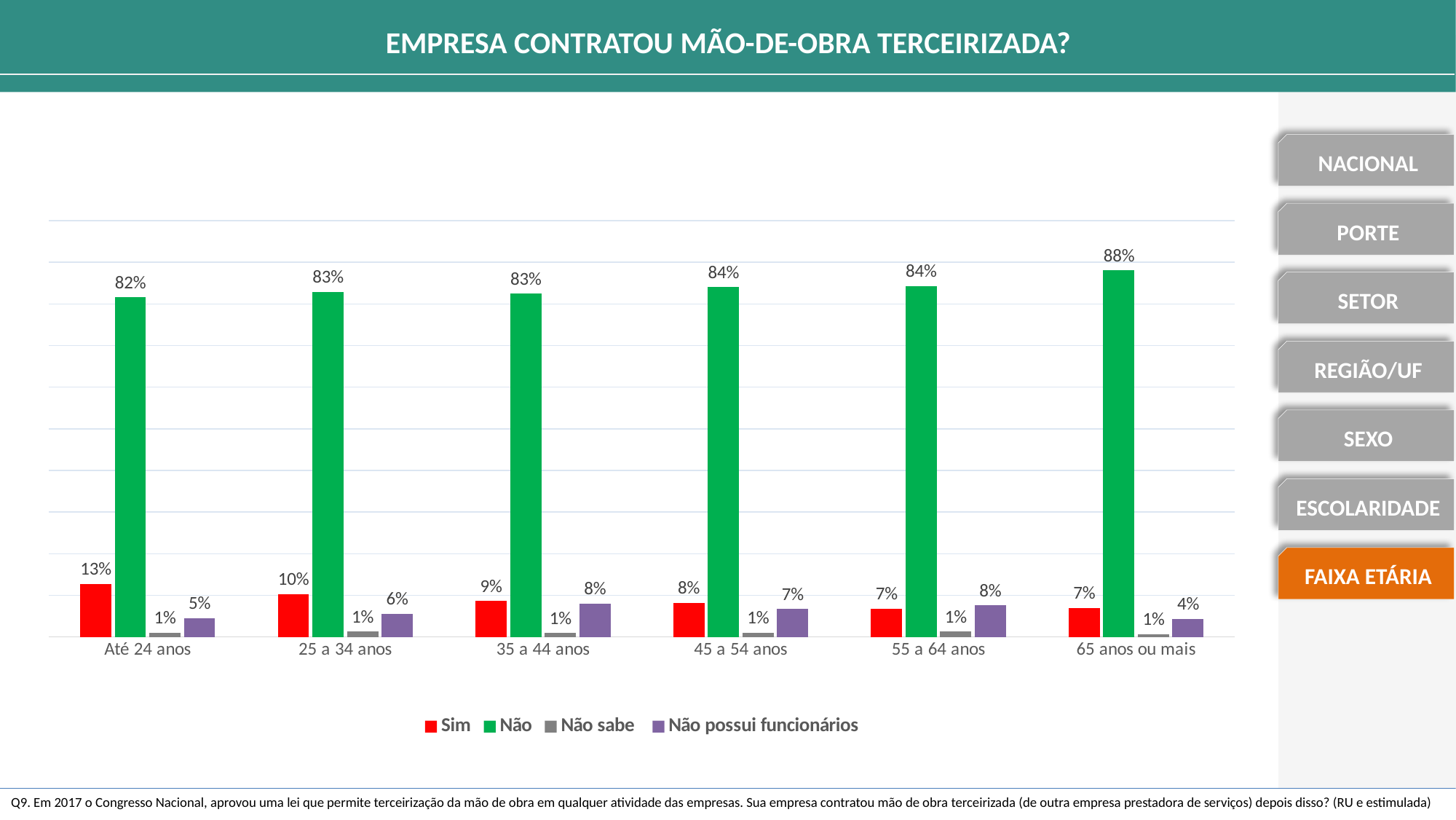
Which is larger: the "Sim" value for "Até 24 anos" or the "Sim" value for "35 a 44 anos"? Até 24 anos How many age categories are shown on the x axis? 6 Does the "Sim" series generally rise or fall from "Até 24 anos" to "65 anos ou mais"? Fall How many series does the legend list? 4 What is the value for "Não possui funcionários" in the "65 anos ou mais" category? 4% What is the value for "Sim" in the "25 a 34 anos" category? 10% What is the value for "Não" in the "Até 24 anos" category? 82% What kind of chart is shown on the slide? Bar chart What colour are the bars for the "Não" series? Green Which age category has the lowest value for "Sim"? 55 a 64 anos and 65 anos ou mais (both 7%) What is the difference between the "Não" value for "65 anos ou mais" and the "Não" value for "Até 24 anos"? 6% Which age category has the highest value for "Não"? 65 anos ou mais